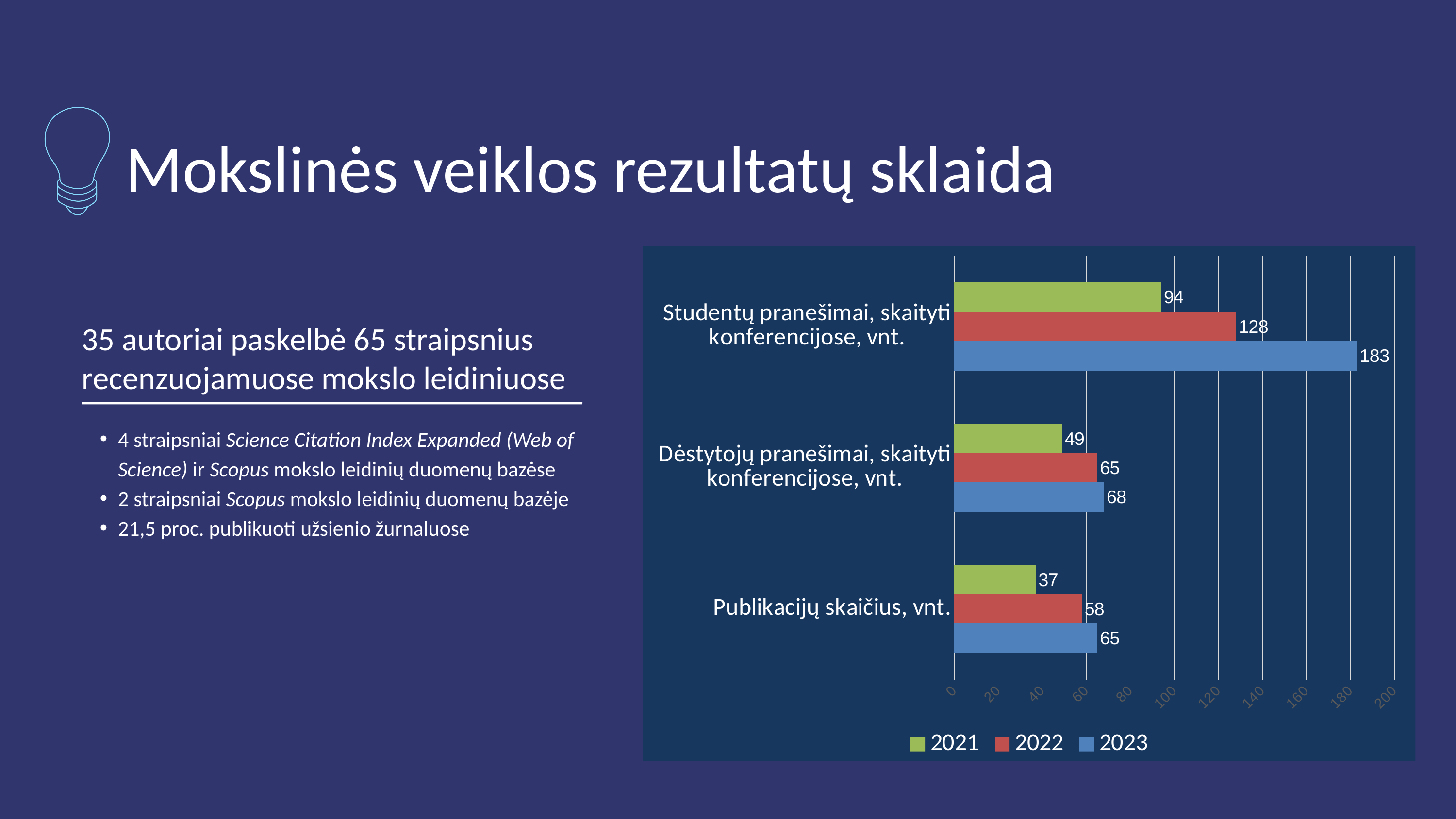
What kind of chart is shown on the slide? Bar chart How many series does the legend list? 3 Which is larger: the 2022 value for Studentų pranešimai or the 2023 value for Dėstytojų pranešimai? 2022 value for Studentų pranešimai Which colour represents the 2022 series in the chart? Red What is the difference between the 2023 and 2021 values for Studentų pranešimai, skaityti konferencijose, vnt.? 89 How many categories are shown on the chart? 3 What is the difference between the 2022 and 2021 values for Publikacijų skaičius, vnt.? 21 Which category has the highest 2023 value? Studentų pranešimai, skaityti konferencijose, vnt. What is the 2021 value for Publikacijų skaičius, vnt.? 37 What is the 2023 value for Studentų pranešimai, skaityti konferencijose, vnt.? 183 What is the 2022 value for Dėstytojų pranešimai, skaityti konferencijose, vnt.? 65 Which category has the lowest 2021 value? Publikacijų skaičius, vnt.